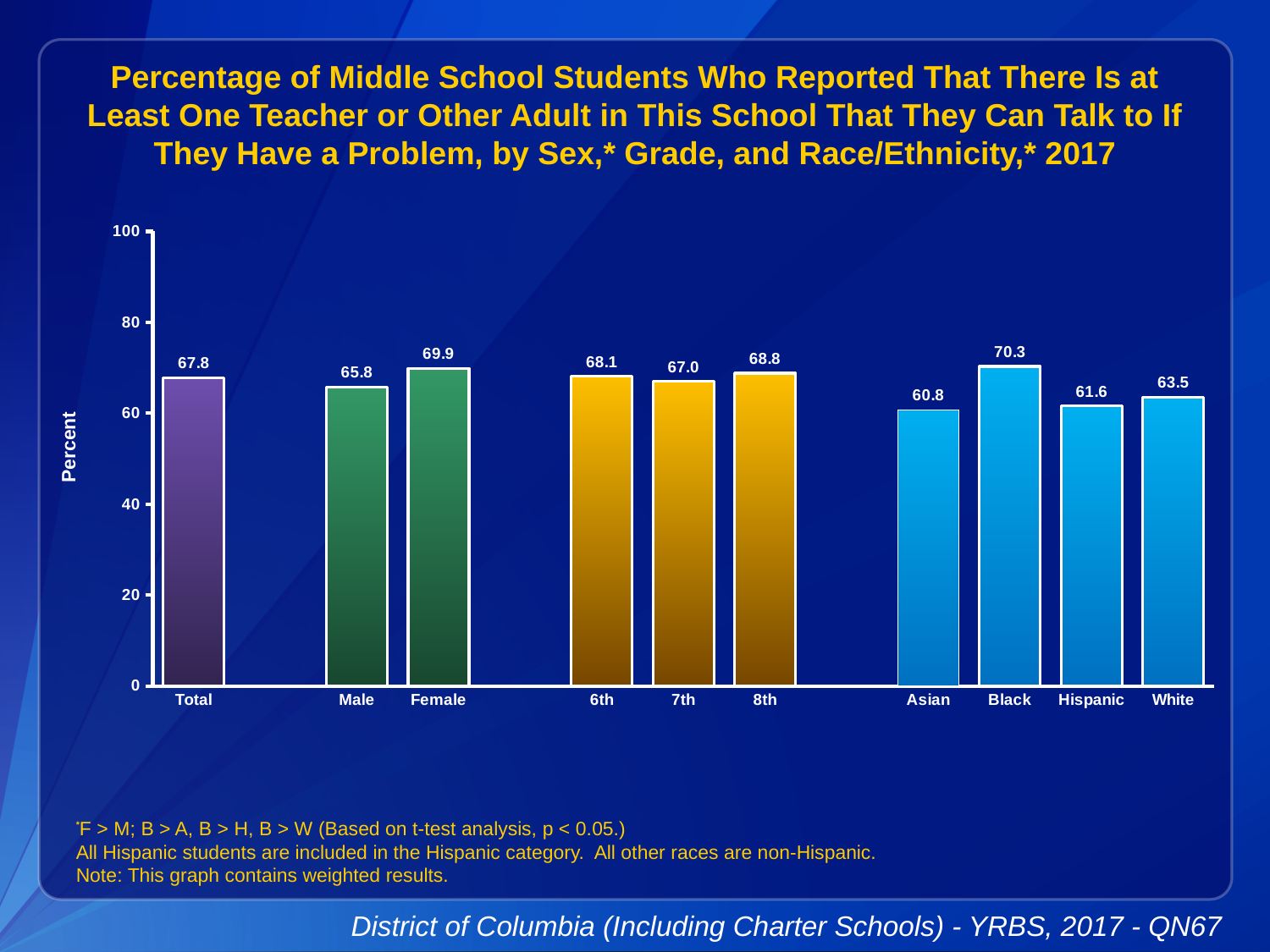
What kind of chart is this? bar chart Which is larger, the value for Black or the value for White? Black What is the value for Asian? 60.8 What is the label of the y axis? Percent Which category has the highest value? Black Which category has the lowest value? Asian Is the value for Hispanic greater or less than 60? greater What is the value for Female? 69.9 What is the value for Total? 67.8 How many categories are shown on the x axis? 10 What is the difference between the Female and Male values? 4.1 What is the value for 7th grade? 67.0